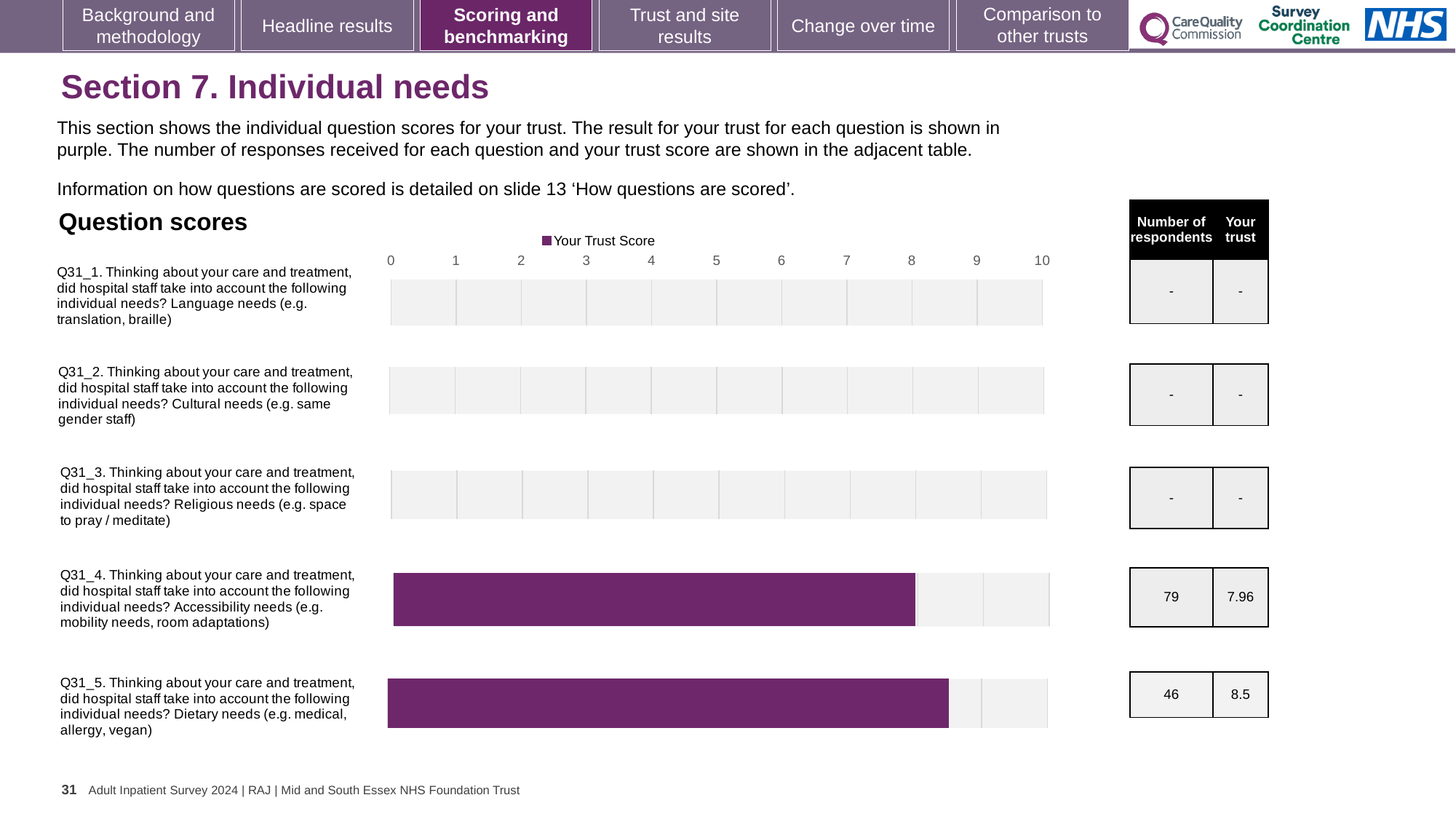
What type of chart is shown on the slide? Bar chart Which has a higher trust score, Q31_4 (Accessibility needs) or Q31_5 (Dietary needs)? Q31_5 (Dietary needs) How many respondents answered Q31_5 (Dietary needs)? 46 Which question has the highest trust score shown on the chart? Q31_5 (Dietary needs) What series does the chart legend list? Your Trust Score Is the trust score for Q31_4 (Accessibility needs) greater or less than 8? less Is the trust score for Q31_5 (Dietary needs) greater or less than 8? greater How many questions are listed on the chart? 5 How many respondents answered Q31_4 (Accessibility needs)? 79 What is the trust score for Q31_5 (Dietary needs)? 8.5 What is the trust score for Q31_4 (Accessibility needs)? 7.96 What is the difference between the trust scores for Q31_5 and Q31_4? 0.54